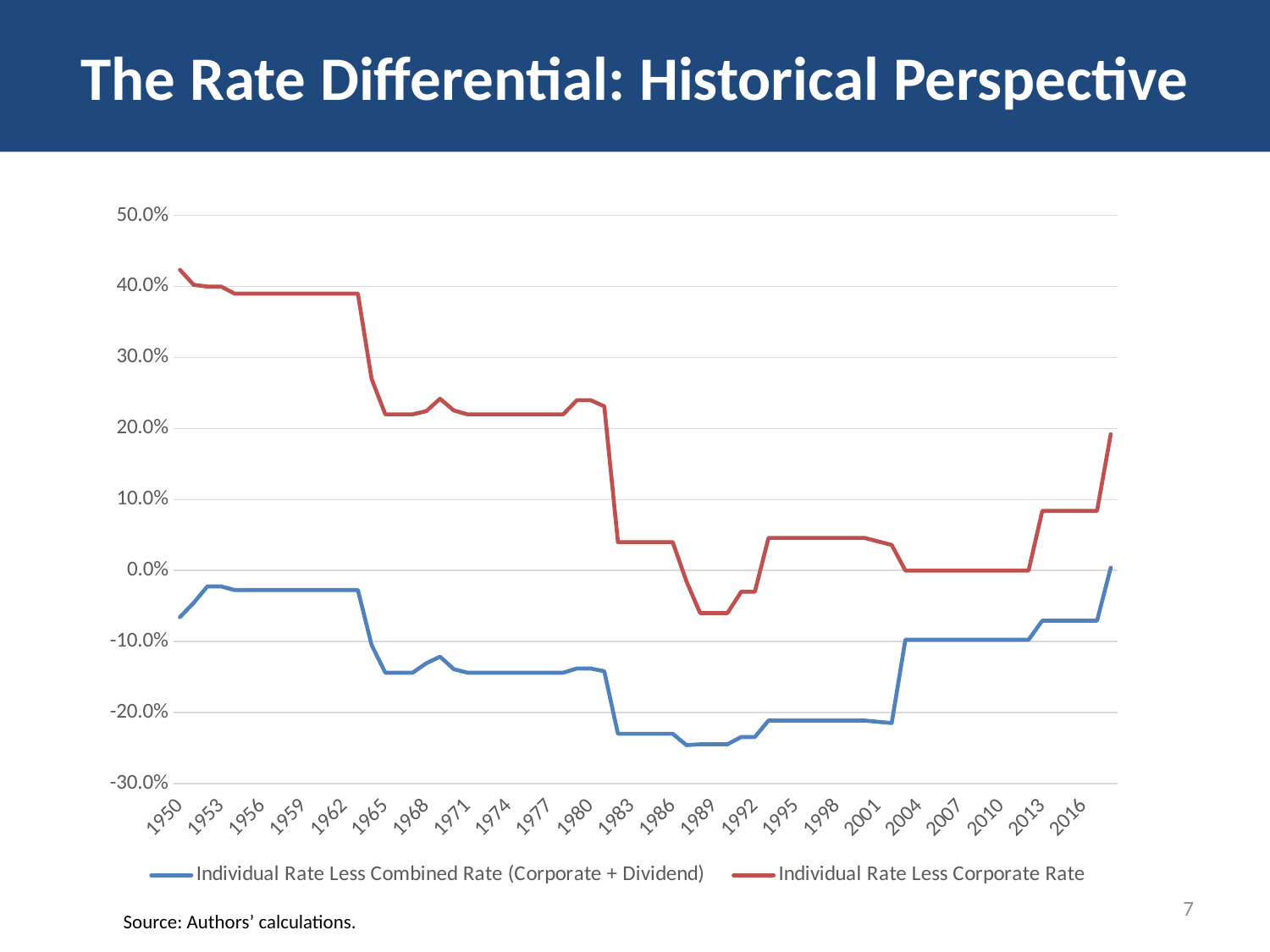
Is the value for Individual Rate Less Corporate Rate in 1950 greater or less than 40.0%? greater Does the Individual Rate Less Corporate Rate series rise or fall between 1950 and 1989? fall What is the title of the slide containing the chart? The Rate Differential: Historical Perspective What kind of chart is shown on the slide? line chart In 1950, which series has the higher value: Individual Rate Less Corporate Rate or Individual Rate Less Combined Rate (Corporate + Dividend)? Individual Rate Less Corporate Rate Is the value for Individual Rate Less Corporate Rate in 1974 greater or less than 20.0%? greater How many series does the legend list? 2 Is the value for Individual Rate Less Combined Rate (Corporate + Dividend) in 1959 greater or less than -10.0%? greater In which year shown on the x axis does the Individual Rate Less Corporate Rate series reach its highest value? 1950 Which series is drawn in red? Individual Rate Less Corporate Rate